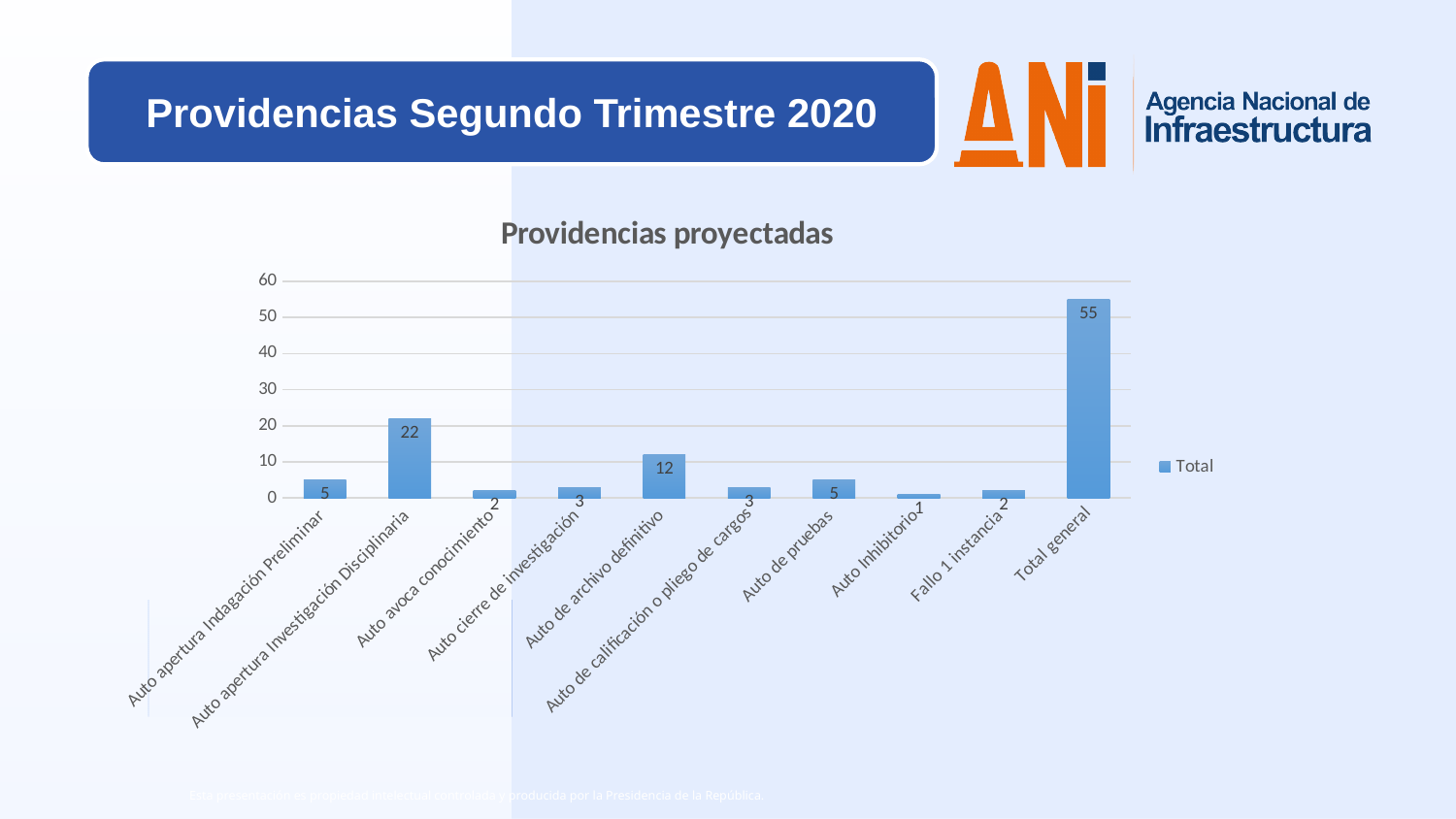
What is the value for "Auto apertura Investigación Disciplinaria"? 22 Which is larger, the value for "Auto de pruebas" or the value for "Fallo 1 instancia"? Auto de pruebas What is the value for "Auto de archivo definitivo"? 12 What type of chart is shown under the title "Providencias proyectadas"? Bar chart How many series does the legend list? 1 Which category has the highest value? Total general What is the name of the series shown in the legend? Total What is the difference between the values for "Auto apertura Investigación Disciplinaria" and "Auto de archivo definitivo"? 10 What is the value for "Auto Inhibitorio"? 1 How many categories are shown on the x axis? 10 What is the value for "Total general"? 55 Which category has the lowest value? Auto Inhibitorio